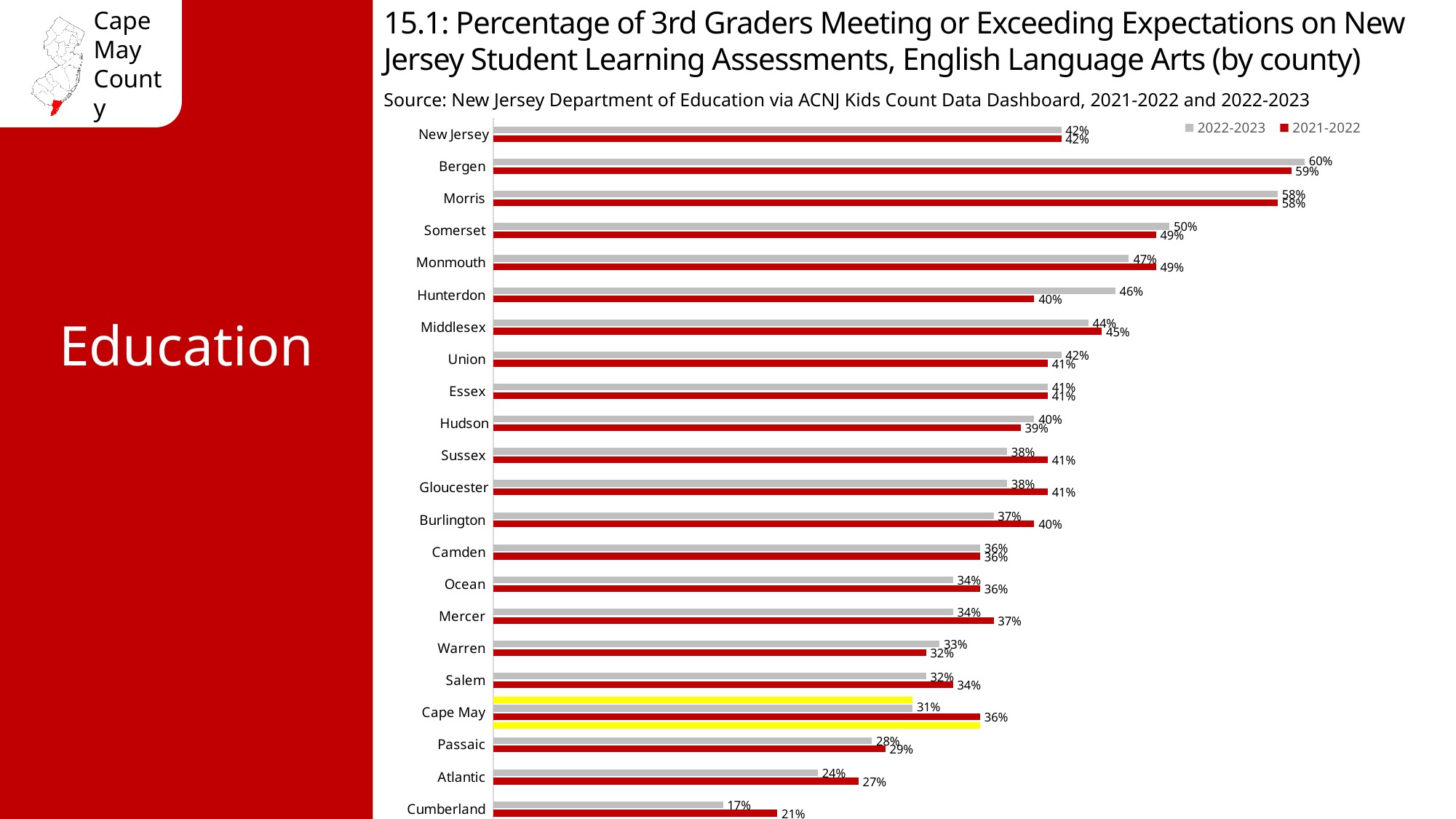
What is the 2022-2023 value for Cumberland? 17% How many series does the legend list? 2 What is the 2021-2022 value for Cape May? 36% Which county has the lowest 2021-2022 value? Cumberland Which series is shown in red in the legend? 2021-2022 What is the 2022-2023 value for Hunterdon? 46% Which is larger for Monmouth: the 2022-2023 value or the 2021-2022 value? 2021-2022 What kind of chart is shown on the slide? Bar chart What is the 2022-2023 value for Cape May? 31% How many categories (counties plus New Jersey) are shown on the chart? 22 Which county has the highest 2022-2023 value? Bergen What is the difference between the 2021-2022 and 2022-2023 values for Hunterdon? 6%